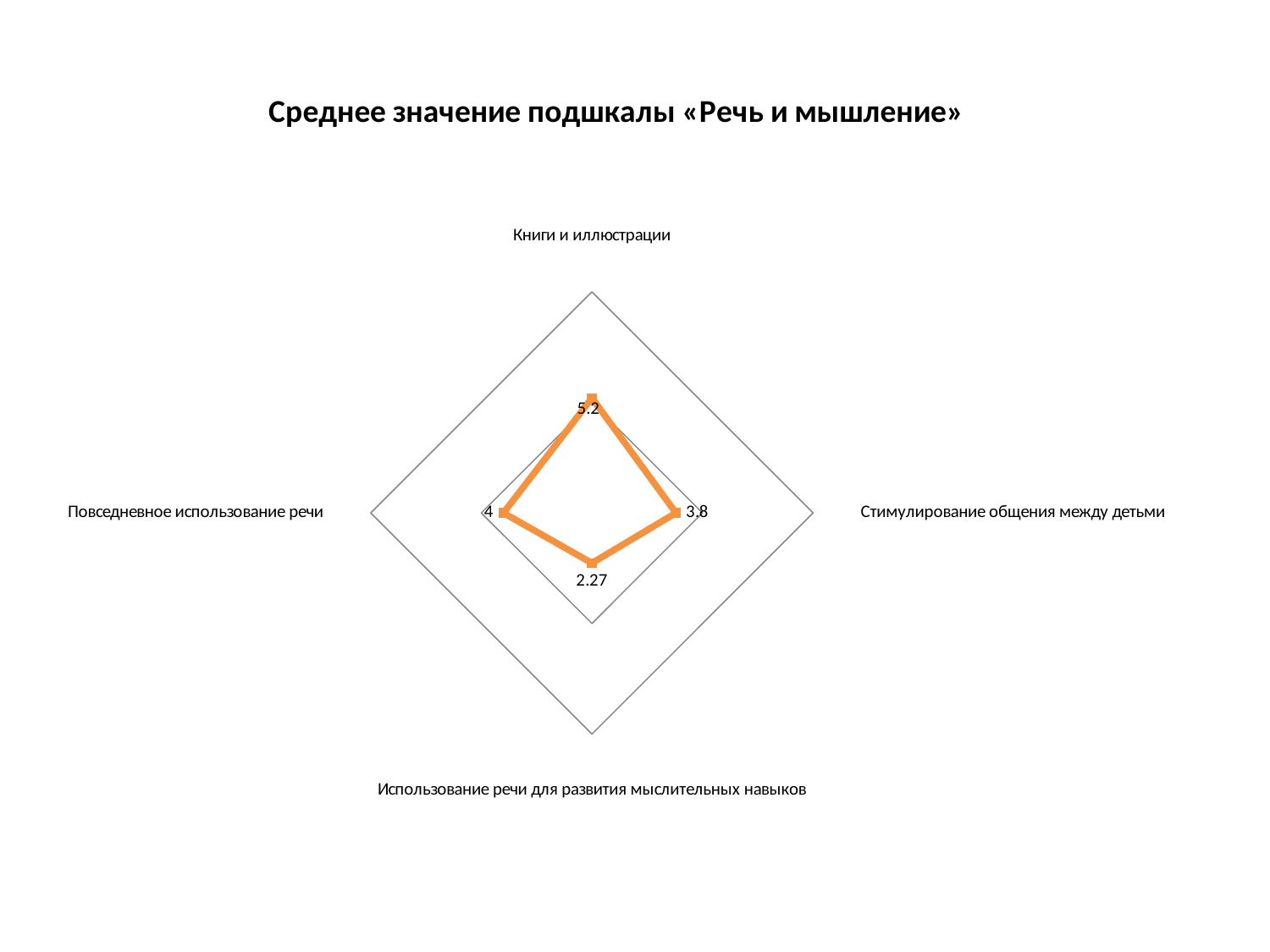
What is the value for «Книги и иллюстрации»? 5.2 What is the difference between the values for «Книги и иллюстрации» and «Использование речи для развития мыслительных навыков»? 2.93 How many categories are plotted on the chart? 4 What is the value for «Стимулирование общения между детьми»? 3.8 Which category has the lowest value? Использование речи для развития мыслительных навыков What is the value for «Использование речи для развития мыслительных навыков»? 2.27 What is the value for «Повседневное использование речи»? 4 Which is larger: the value for «Повседневное использование речи» or for «Стимулирование общения между детьми»? Повседневное использование речи What is the title of the chart? Среднее значение подшкалы «Речь и мышление» Which category has the highest value? Книги и иллюстрации What kind of chart is shown on the slide? Radar chart What is the difference between the values for «Повседневное использование речи» and «Стимулирование общения между детьми»? 0.2